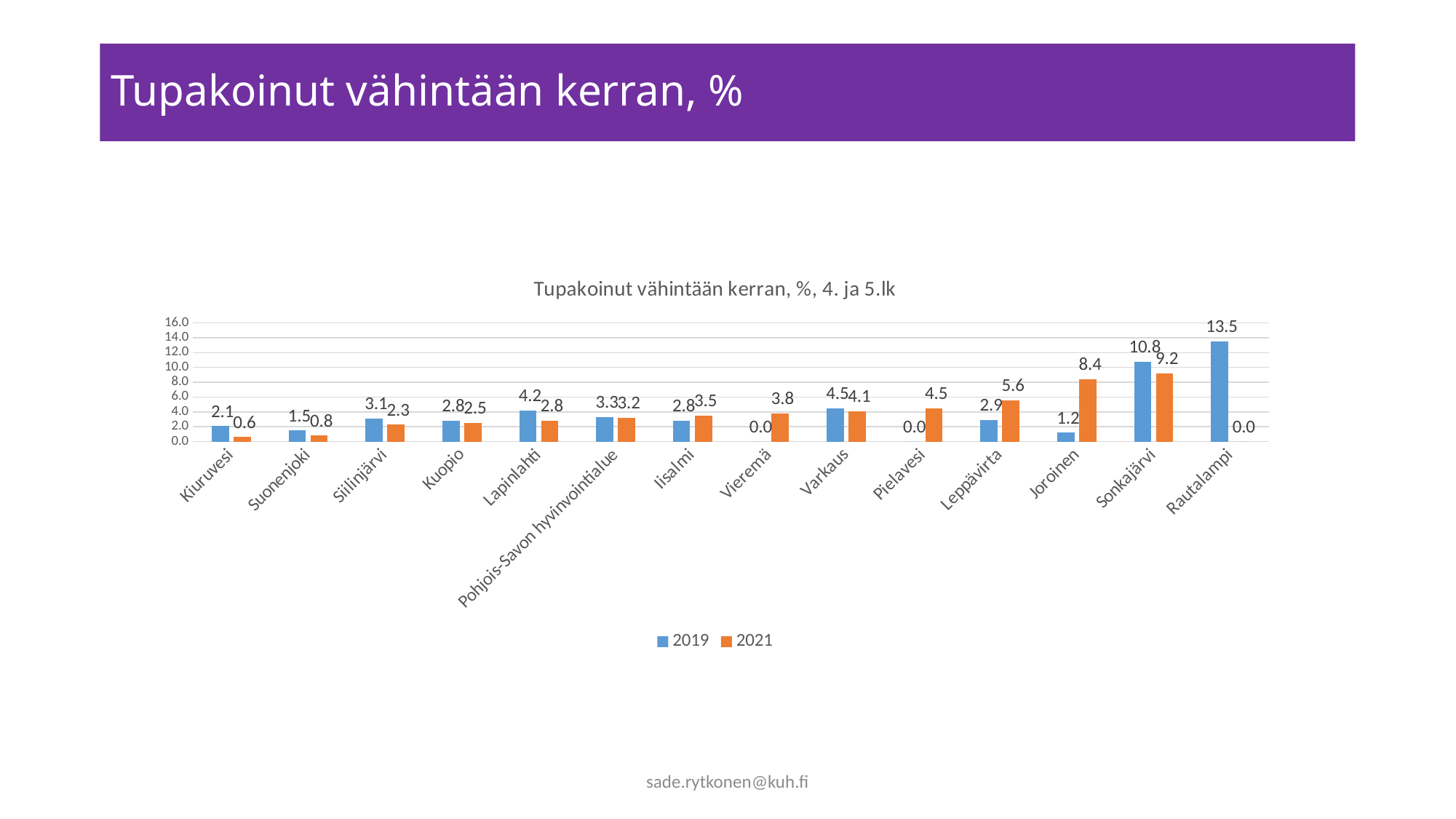
What is the difference between the 2019 and 2021 values for Sonkajärvi? 1.6 What kind of chart is shown on the slide? Bar chart Which is larger for Vieremä, the 2019 value or the 2021 value? 2021 What is the 2019 value for Lapinlahti? 4.2 What is the 2021 value for Leppävirta? 5.6 Which category has the highest 2019 value? Rautalampi What is the 2019 value for Rautalampi? 13.5 How many categories are shown on the x axis? 14 What is the title of the chart? Tupakoinut vähintään kerran, %, 4. ja 5.lk What is the 2021 value for Joroinen? 8.4 How many series does the legend list? 2 Which category has the lowest 2021 value? Rautalampi